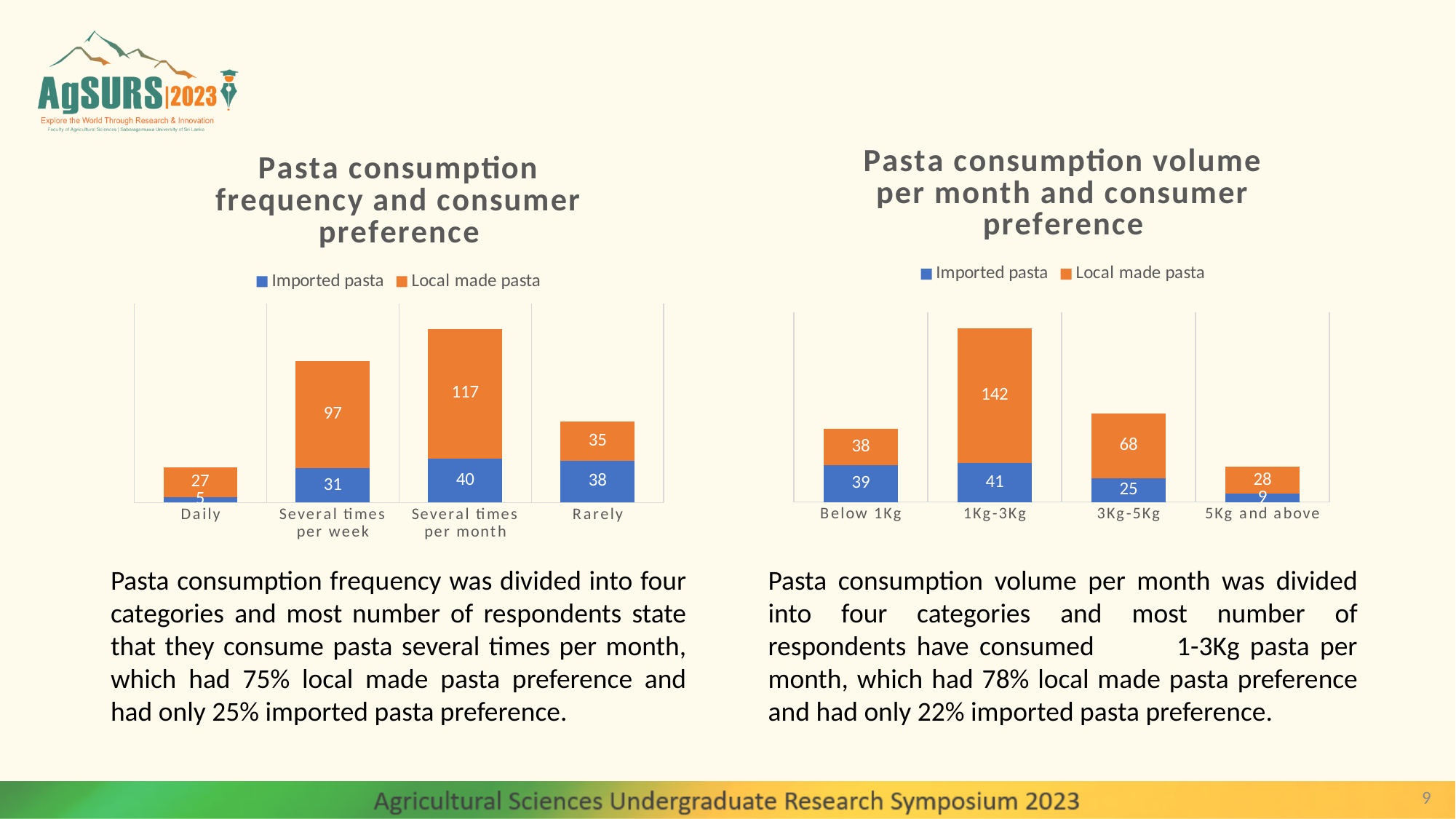
In the 'Pasta consumption frequency and consumer preference' chart, what is the difference between Local made pasta and Imported pasta in the 'Rarely' category? 3 In the 'Pasta consumption volume per month and consumer preference' chart, which category has the lowest Imported pasta value? 5Kg and above In the 'Pasta consumption frequency and consumer preference' chart, what is the value for Imported pasta in the 'Daily' category? 5 In the 'Pasta consumption volume per month and consumer preference' chart, what is the total of the stacked bar for 'Below 1Kg'? 77 In the 'Pasta consumption frequency and consumer preference' chart, how many categories are shown on the x axis? 4 In the 'Pasta consumption volume per month and consumer preference' chart, what is the value for Local made pasta in the '1Kg-3Kg' category? 142 In the 'Pasta consumption frequency and consumer preference' chart, what is the value for Local made pasta in the 'Several times per month' category? 117 In the 'Pasta consumption frequency and consumer preference' chart, what is the total of the stacked bar for 'Several times per week'? 128 In the 'Pasta consumption frequency and consumer preference' chart, which category has the highest Local made pasta value? Several times per month In the 'Pasta consumption volume per month and consumer preference' chart, what is the value for Imported pasta in the '3Kg-5Kg' category? 25 How many series does the legend of the 'Pasta consumption volume per month and consumer preference' chart list? 2 In the 'Pasta consumption volume per month and consumer preference' chart, is the Local made pasta value for '1Kg-3Kg' larger or smaller than the Local made pasta value for '3Kg-5Kg'? larger